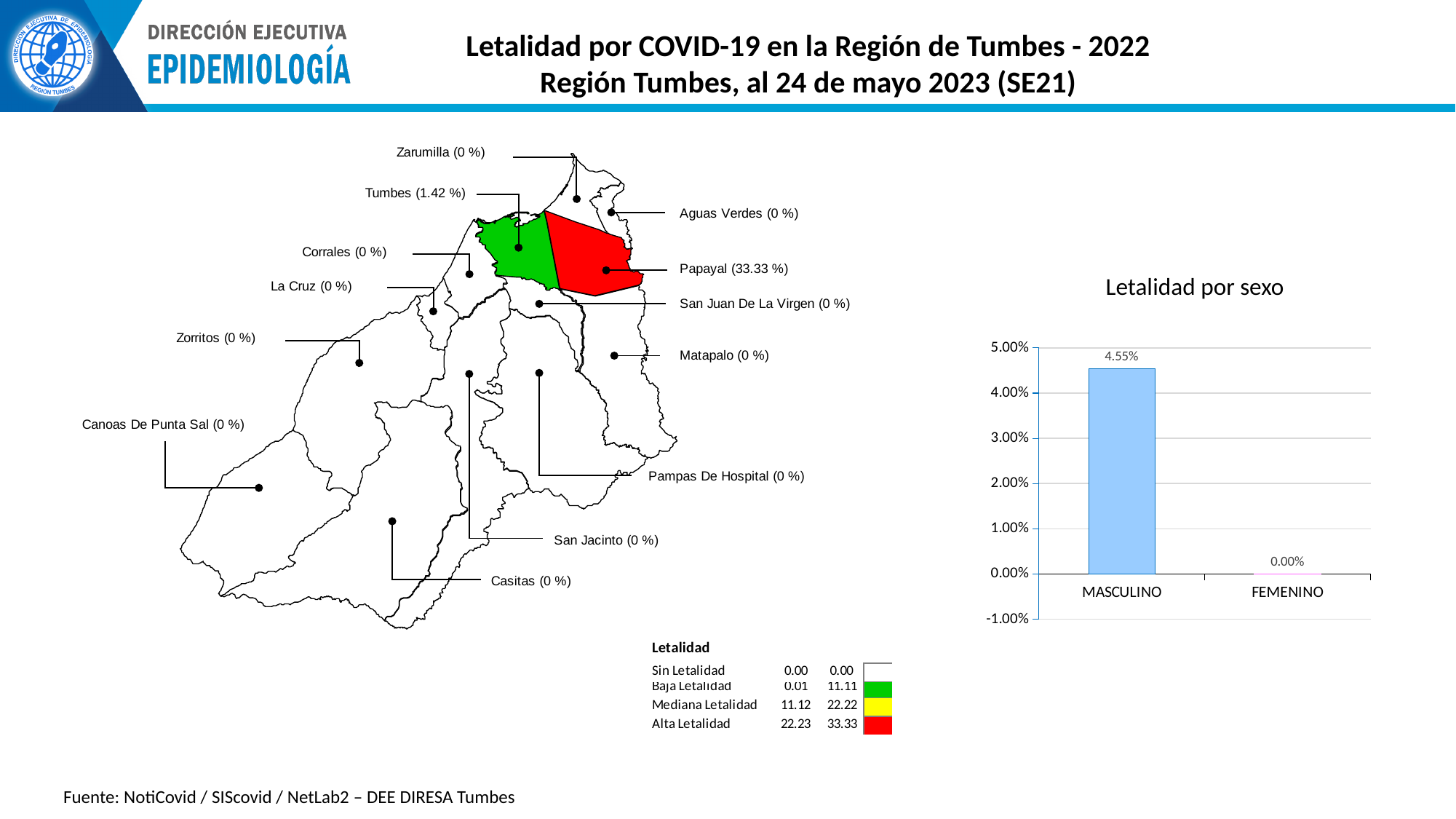
In the 'Letalidad por sexo' chart, what is the value for MASCULINO? 4.55% On the map on the left, what is the lethality value shown for Tumbes? 1.42 % In the 'Letalidad por sexo' chart, what is the lowest value shown on the vertical axis? -1.00% In the 'Letalidad por sexo' chart, what is the difference between the MASCULINO and FEMENINO values? 4.55% In the 'Letalidad por sexo' chart, which category has the lowest value? FEMENINO On the map on the left, what is the lethality value shown for Papayal? 33.33 % How many categories are shown in the 'Letalidad por sexo' chart? 2 In the 'Letalidad por sexo' chart, is the value for MASCULINO greater or less than 4.00%? greater In the 'Letalidad por sexo' chart, what is the value for FEMENINO? 0.00% On the map on the left, which district has the highest lethality value? Papayal What kind of chart is 'Letalidad por sexo'? bar chart In the 'Letalidad por sexo' chart, which category has the highest value? MASCULINO